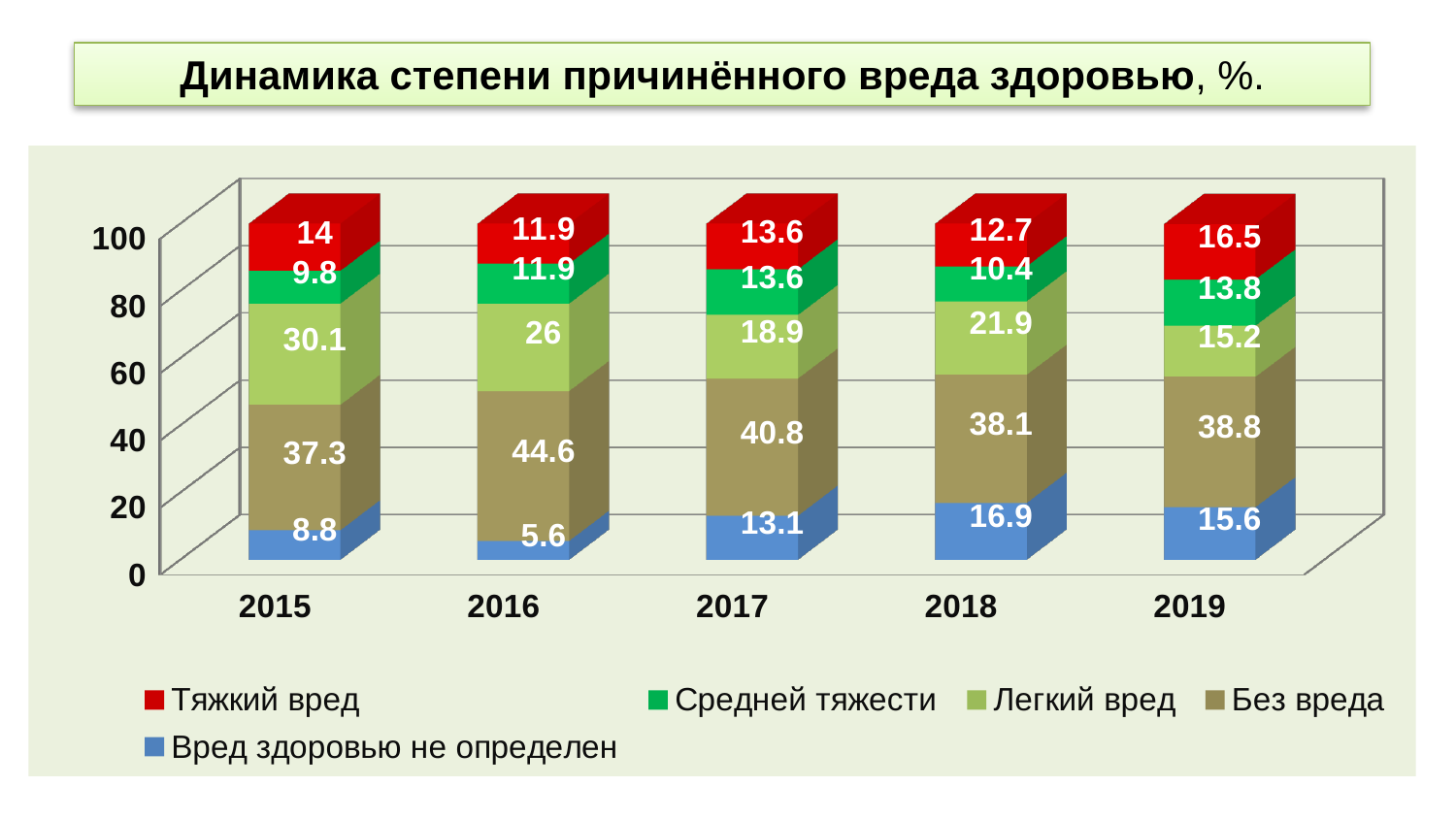
How many series does the legend list? 5 What is the value for Без вреда in 2016? 44.6 In which year is the value for Тяжкий вред the highest? 2019 What is the difference between the Легкий вред values for 2015 and 2019? 14.9 What is the value for Легкий вред in 2017? 18.9 What is the total of the stacked bar for 2015? 100 Which is larger: Без вреда in 2017 or Без вреда in 2018? 2017 How many years are shown on the x axis? 5 What is the value for Тяжкий вред in 2019? 16.5 What kind of chart is shown on the slide? Stacked bar chart In which year is the value for Вред здоровью не определен the lowest? 2016 What is the value for Вред здоровью не определен in 2018? 16.9